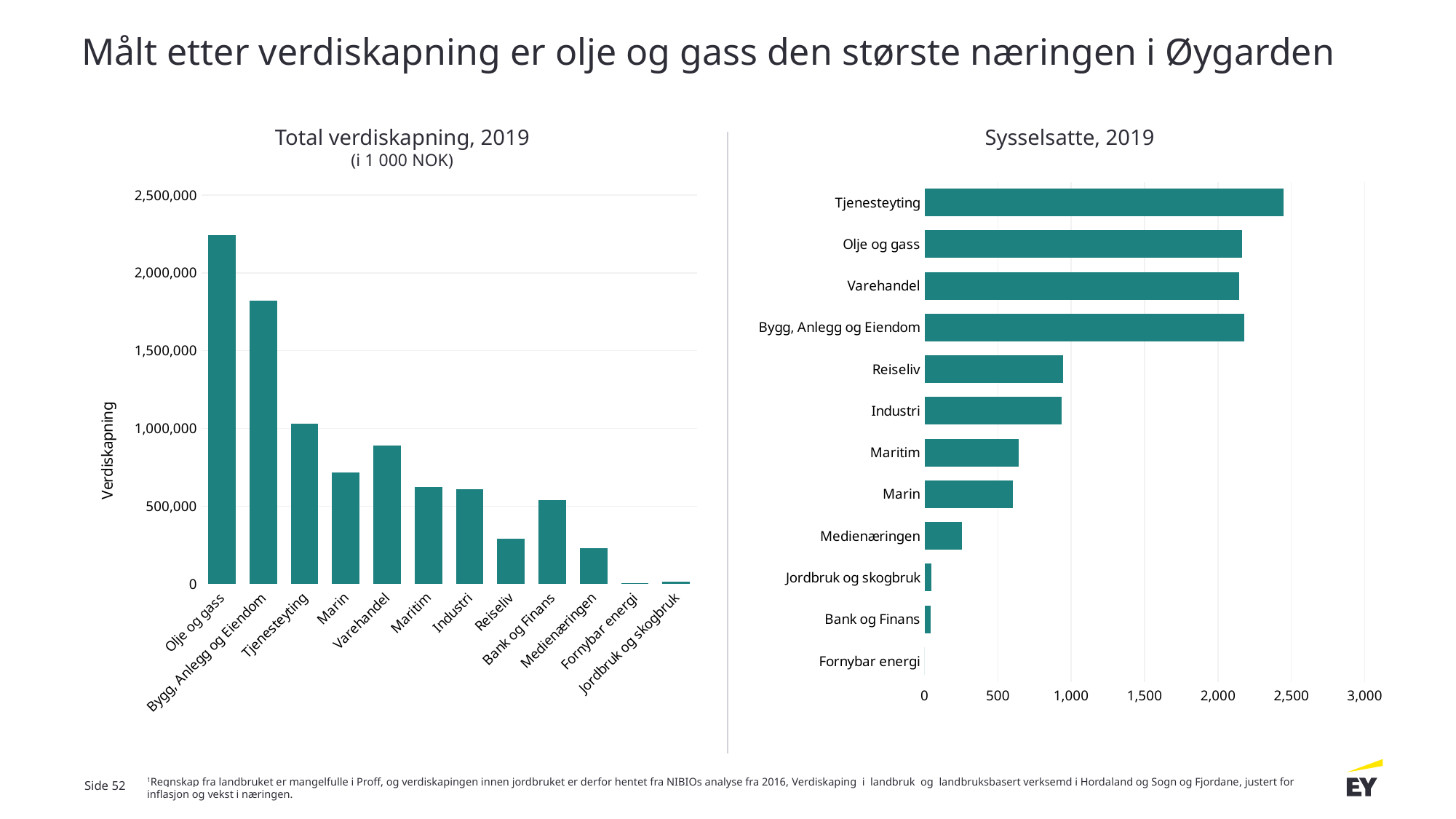
In the 'Sysselsatte, 2019' chart, which category has the longest bar? Tjenesteyting In the 'Sysselsatte, 2019' chart, is the value for Tjenesteyting greater or less than 2,000? greater In the 'Sysselsatte, 2019' chart, is the value for Medienæringen greater or less than 500? less In the 'Sysselsatte, 2019' chart, which is larger: Reiseliv or Maritim? Reiseliv What is the y-axis label of the 'Total verdiskapning, 2019' chart? Verdiskapning In the 'Total verdiskapning, 2019' chart, is the value for Reiseliv greater or less than 500,000? less What kind of chart is the 'Total verdiskapning, 2019' chart on the left? bar chart How many categories are shown in the 'Sysselsatte, 2019' chart on the right? 12 In the 'Sysselsatte, 2019' chart, which category has the lowest value? Fornybar energi In the 'Total verdiskapning, 2019' chart, which is larger: Marin or Varehandel? Varehandel In the 'Total verdiskapning, 2019' chart, which category has the highest value? Olje og gass